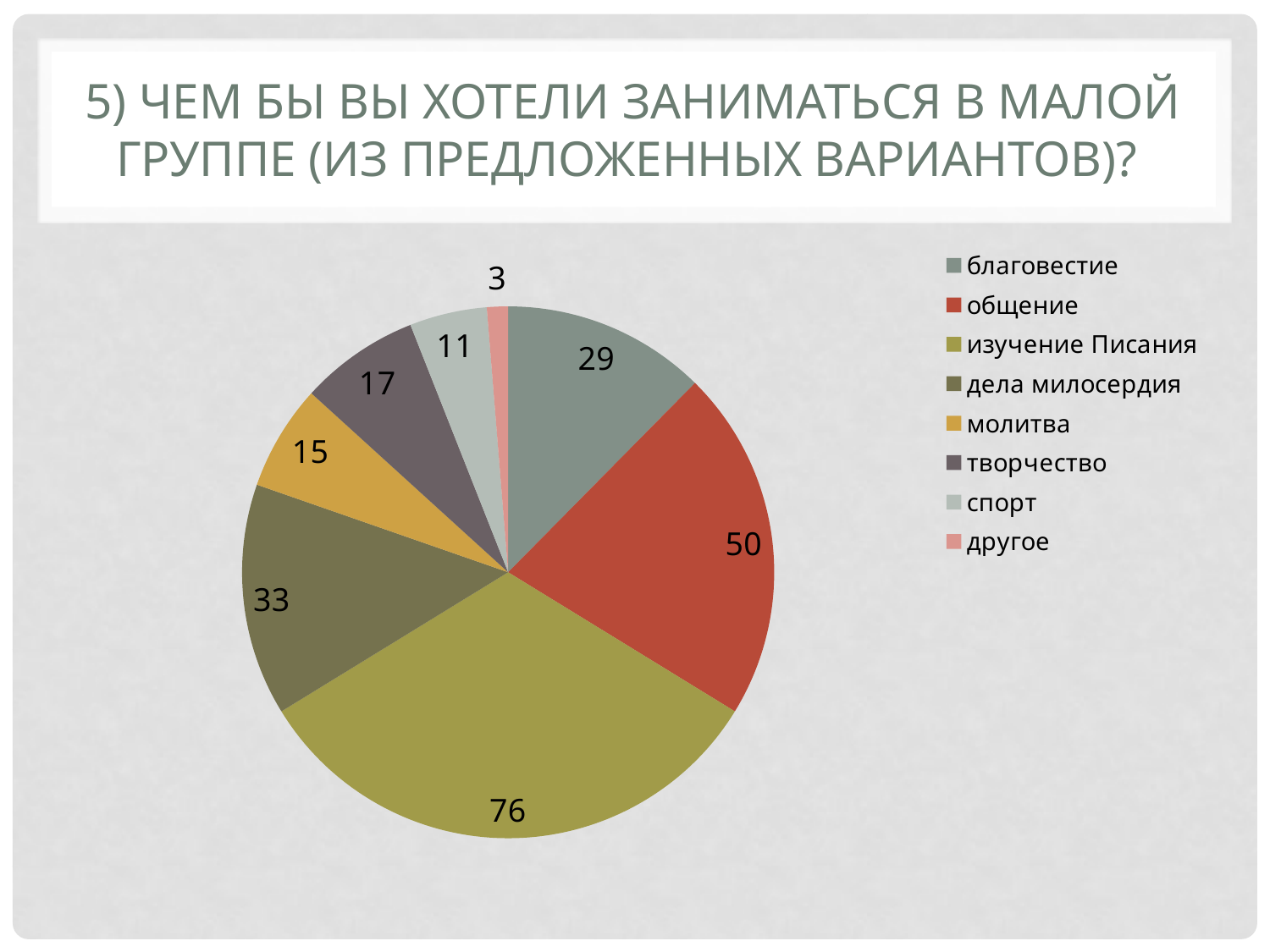
What kind of chart is shown on the slide? pie chart What is the total of all the values shown in the pie chart? 234 What is the difference between the values for дела милосердия and молитва? 18 Which category has the largest slice of the pie? изучение Писания What value is shown for the спорт slice? 11 What value is shown for the изучение Писания slice? 76 Which is larger, the value for творчество or the value for молитва? творчество How many categories does the pie chart show? 8 Which category has the smallest slice of the pie? другое What value is shown for the общение slice? 50 Which category is shown in red in the legend? общение What is the difference between the values for изучение Писания and общение? 26